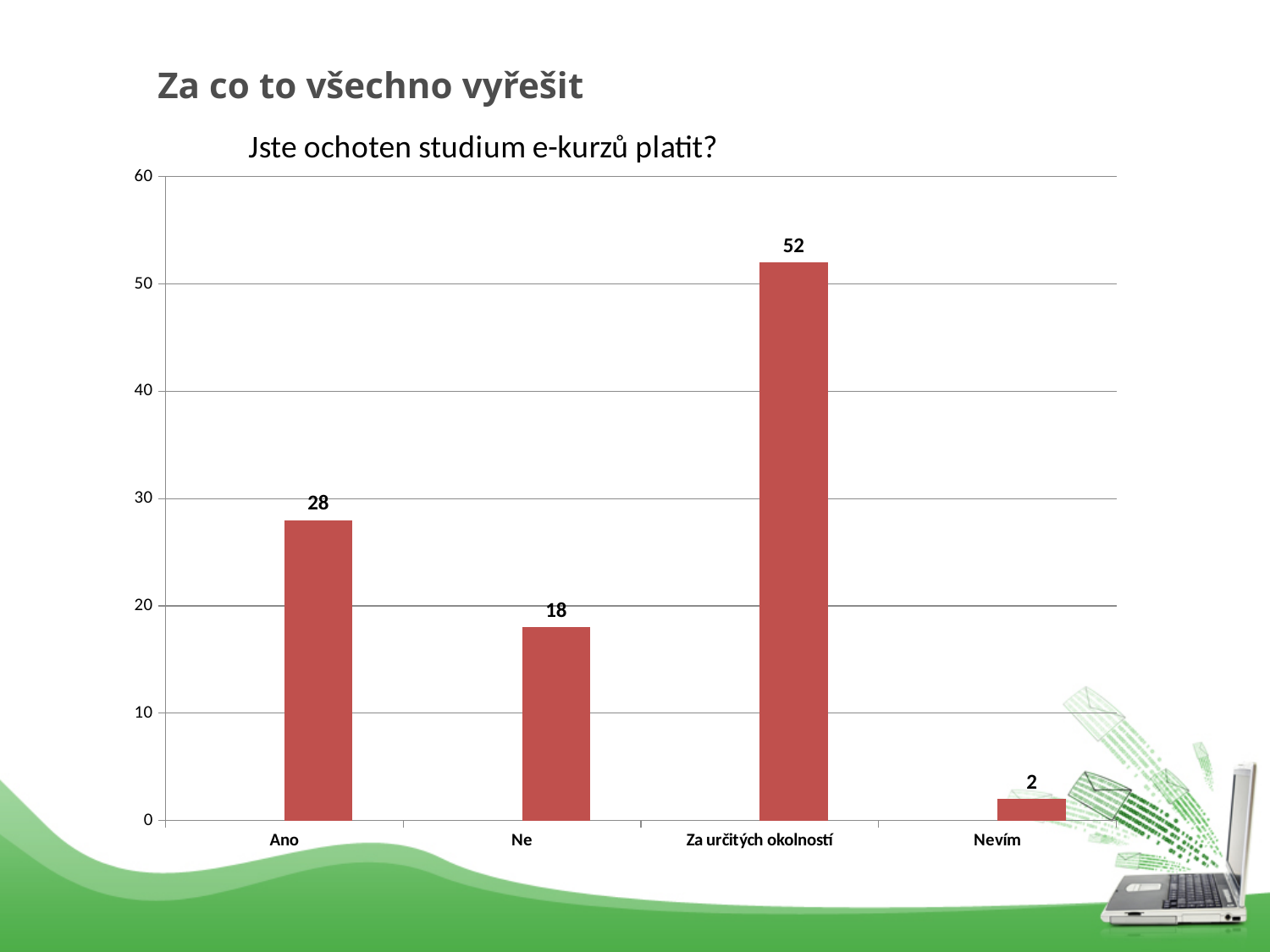
What is the value for "Ne"? 18 Which is larger, the value for "Ano" or the value for "Ne"? Ano What is the title of the chart? Jste ochoten studium e-kurzů platit? What is the value for "Za určitých okolností"? 52 Which category has the lowest value? Nevím How many categories are shown on the x axis? 4 Which category has the highest value? Za určitých okolností What is the value for "Ano"? 28 What is the difference between the values for "Za určitých okolností" and "Ano"? 24 What kind of chart is shown on the slide? bar chart What is the value for "Nevím"? 2 Is the value for "Za určitých okolností" greater or less than 50? greater